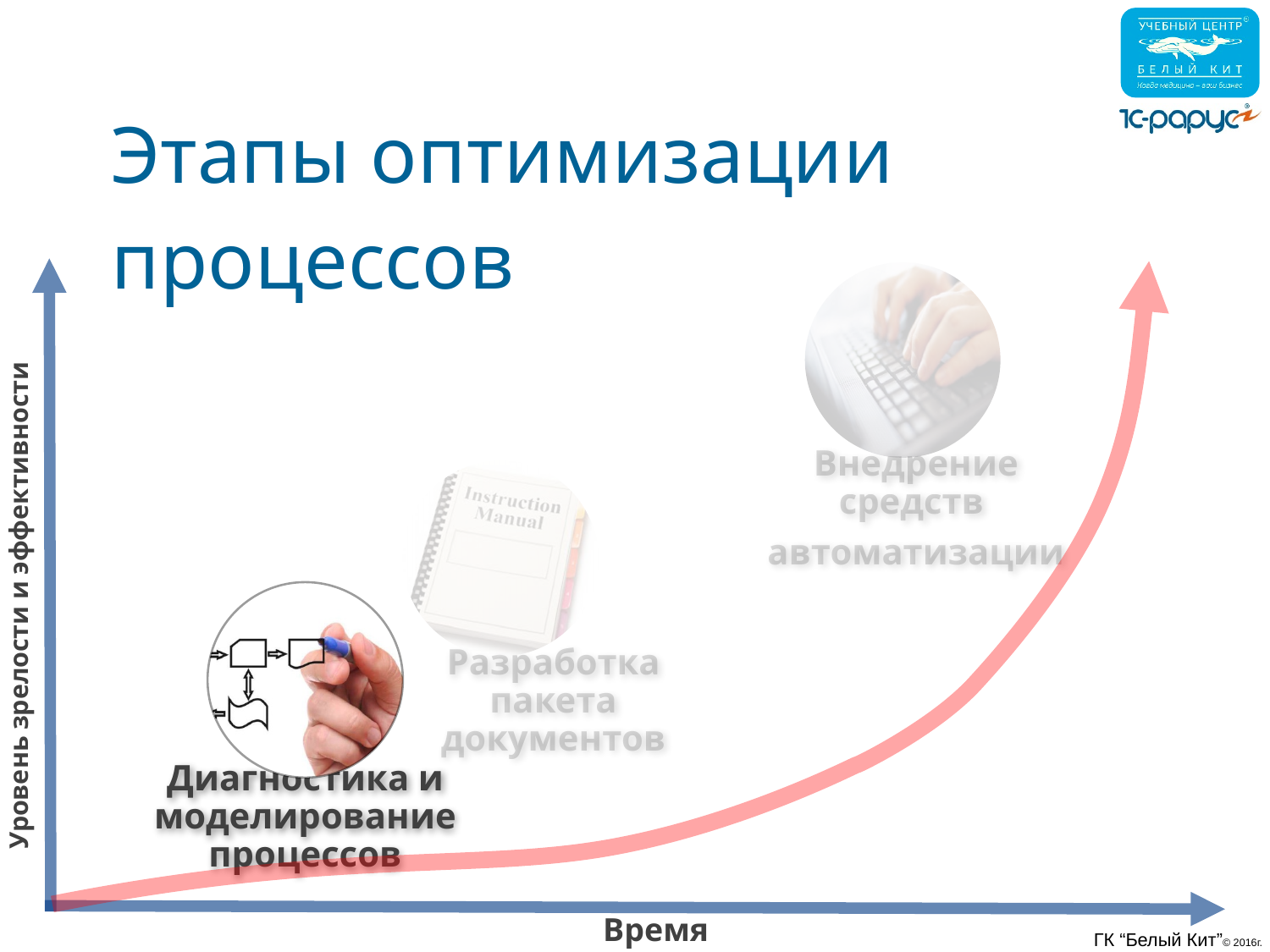
How many stages (этапы) are marked along the curve on the diagram? 3 Which stage is placed higher on the curve: Разработка пакета документов or Диагностика и моделирование процессов? Разработка пакета документов Which stage is placed first (lowest and leftmost) on the curve? Диагностика и моделирование процессов What is the label of the vertical axis of the diagram? Уровень зрелости и эффективности Which stage is placed highest (rightmost) on the curve? Внедрение средств автоматизации What is the label of the horizontal axis of the diagram? Время Does the curve on the diagram rise or fall as it moves along the x axis (Время)? rise